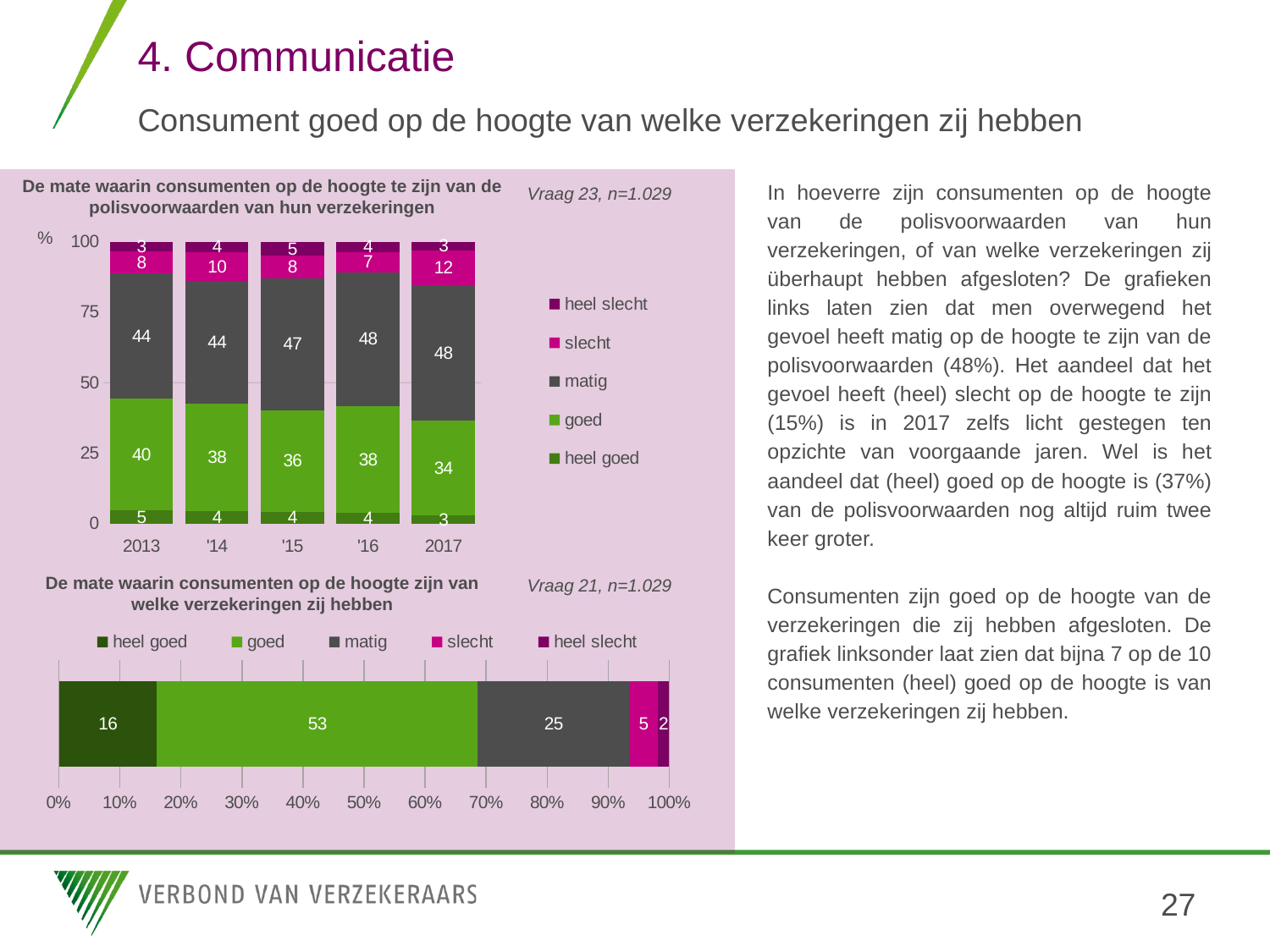
In the top chart, how many series does the legend list? 5 In the bottom chart 'De mate waarin consumenten op de hoogte zijn van welke verzekeringen zij hebben', what is the value for 'goed'? 53 In the top chart, what is the value for 'goed' in 2013? 40 In the top chart, which year has the highest value for 'slecht'? 2017 In the top chart, how many years are shown on the x axis? 5 What kind of chart is the bottom chart? Stacked horizontal bar chart In the top chart 'De mate waarin consumenten op de hoogte te zijn van de polisvoorwaarden van hun verzekeringen', what is the value for 'matig' in 2017? 48 In the bottom chart, what is the difference between the 'goed' and 'matig' values? 28 In the top chart, what is the difference between the 'goed' values for 2013 and 2017? 6 In the top chart, which year has the lowest value for 'goed'? 2017 In the top chart, what is the value for 'slecht' in '14? 10 In the top chart, is the 'matig' value larger in '15 or in '14? '15